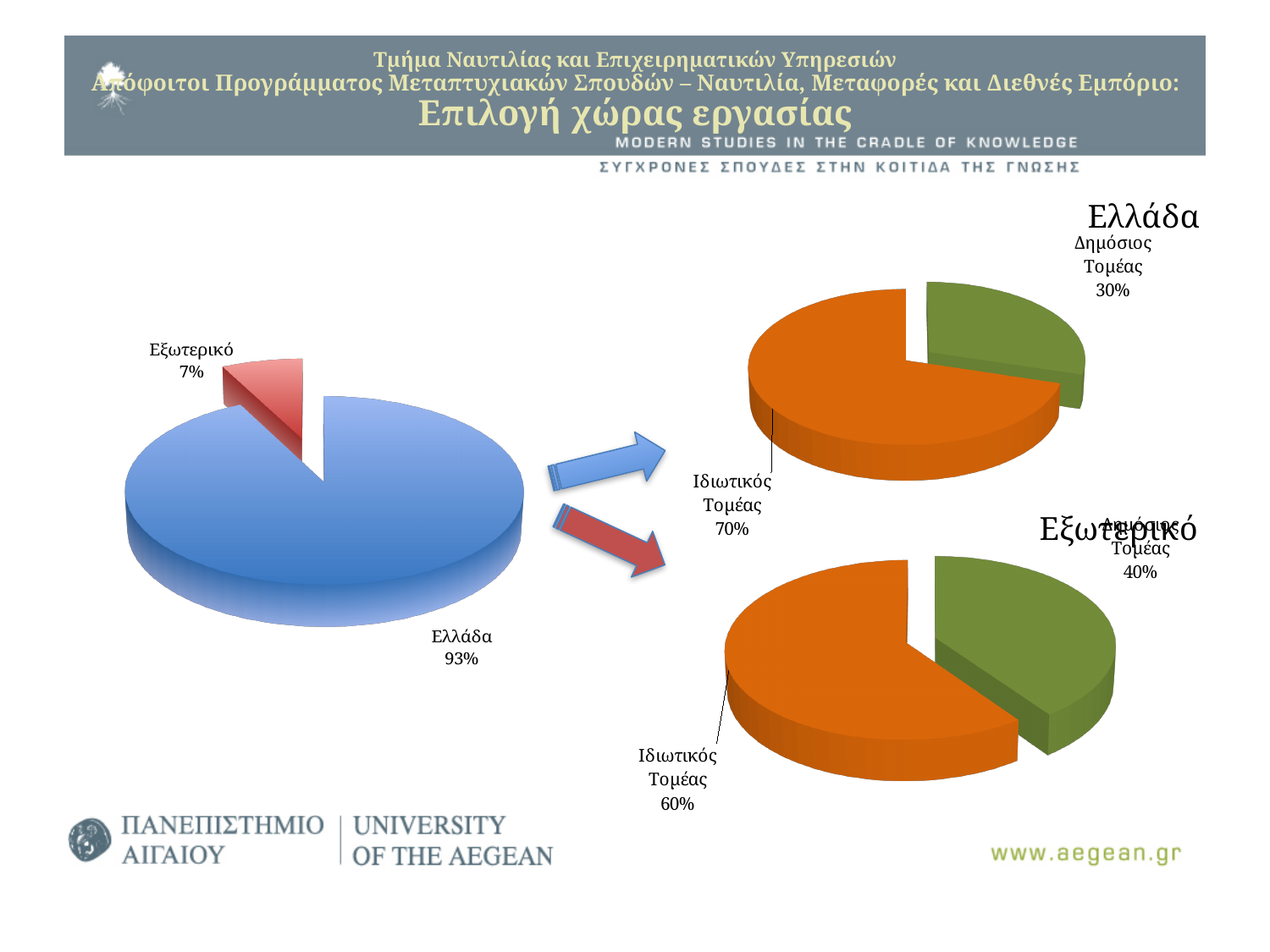
In the pie chart on the left of the slide, what is the difference in percentage points between Ελλάδα and Εξωτερικό? 86 In the pie chart titled Εξωτερικό (bottom right), what percentage is shown for Ιδιωτικός Τομέας? 60% In the pie chart on the left of the slide, what percentage is shown for Εξωτερικό? 7% In the pie chart titled Ελλάδα (top right), which slice is the smallest? Δημόσιος Τομέας In the pie chart on the left of the slide, which slice is the largest? Ελλάδα In the pie chart titled Εξωτερικό (bottom right), what percentage is shown for Δημόσιος Τομέας? 40% In the pie chart titled Ελλάδα (top right), what percentage is shown for Ιδιωτικός Τομέας? 70% In the pie chart titled Εξωτερικό (bottom right), which is larger, Ιδιωτικός Τομέας or Δημόσιος Τομέας? Ιδιωτικός Τομέας In the pie chart titled Ελλάδα (top right), what percentage is shown for Δημόσιος Τομέας? 30% In the pie chart on the left of the slide, what percentage is shown for Ελλάδα? 93% What type of chart is used on the left of the slide? Pie chart How many pie charts are shown on the slide? 3